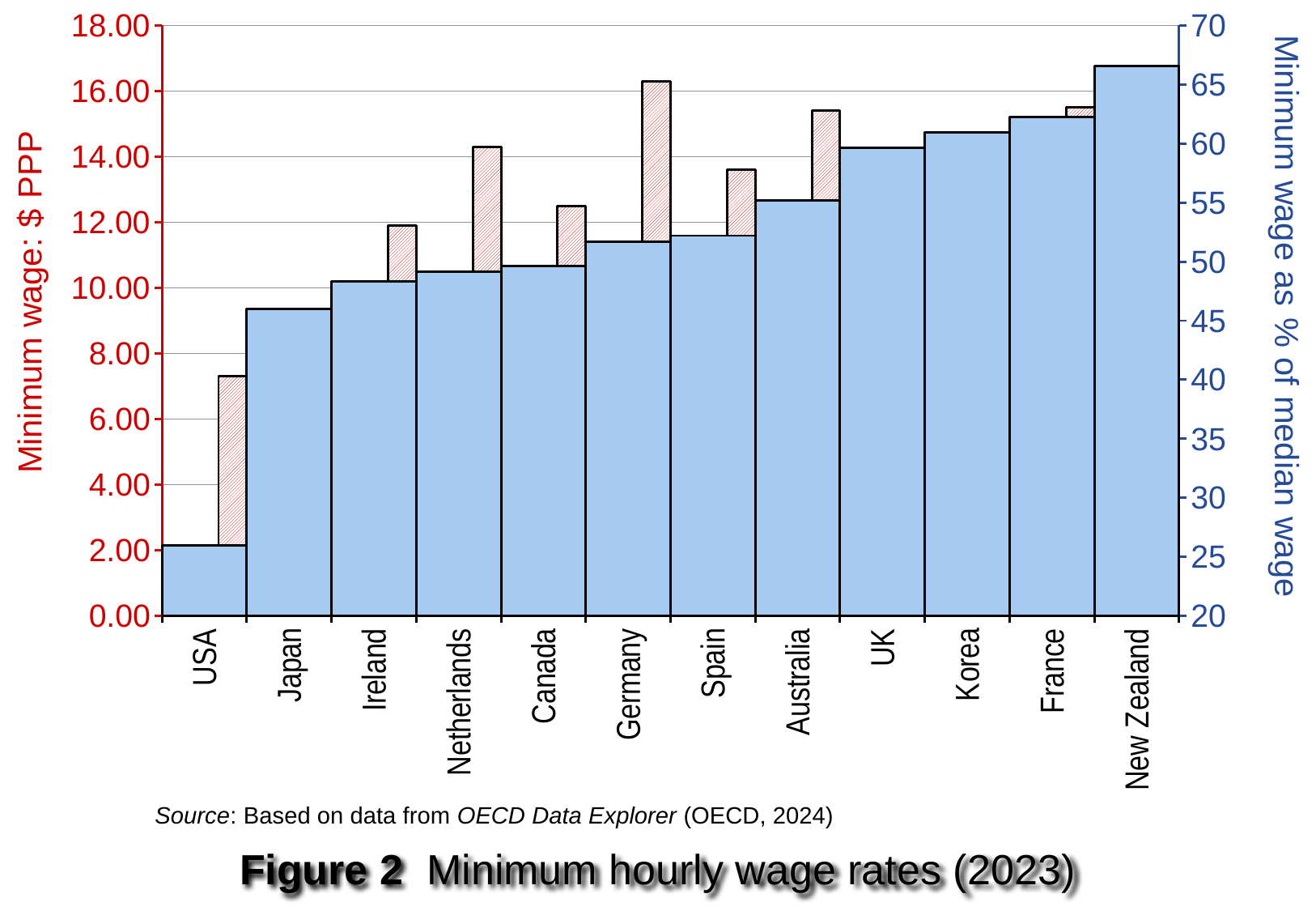
Which country has the highest minimum wage as % of median wage (blue bars)? New Zealand Which has the larger minimum wage in $ PPP, Germany or the Netherlands? Germany What is the label of the left (red) vertical axis? Minimum wage: $ PPP Is the minimum wage in $ PPP for the USA greater or less than 8.00? less What kind of chart is shown in Figure 2? bar chart Which country has the highest minimum wage in $ PPP (red hatched bars)? Germany Which country has the lowest minimum wage as % of median wage (blue bars)? USA Is the minimum wage as % of median wage for New Zealand greater or less than 60? greater Do the blue bars (minimum wage as % of median wage) rise or fall from left to right across the countries? rise Is the minimum wage as % of median wage for the USA greater or less than 30? less How many countries are shown on the x axis of the chart? 12